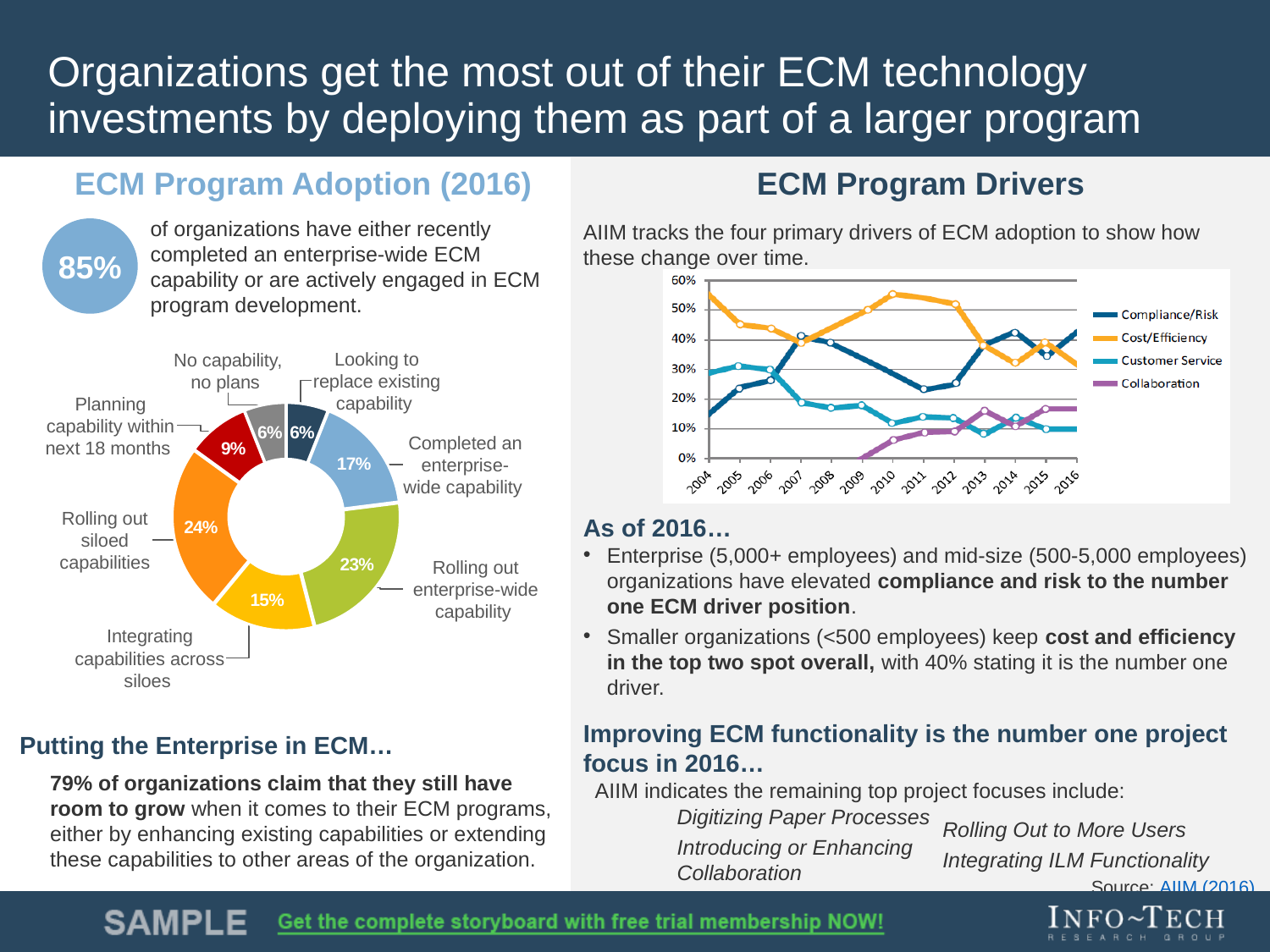
What kind of chart is the ECM Program Adoption (2016) chart? Donut (pie) chart On the ECM Program Adoption (2016) chart, what is the difference between 'Rolling out enterprise-wide capability' and 'Planning capability within next 18 months'? 14% On the ECM Program Adoption (2016) chart, what share is labelled 'Completed an enterprise-wide capability'? 17% On the ECM Program Drivers chart, is the value for Cost/Efficiency in 2004 greater or less than 50%? greater On the ECM Program Adoption (2016) chart, what percentage of organizations are rolling out siloed capabilities? 24% On the ECM Program Adoption (2016) chart, what percentage is shown for 'Integrating capabilities across siloes'? 15% On the ECM Program Drivers chart, is the value for Compliance/Risk in 2004 greater or less than 20%? less On the ECM Program Drivers chart, which is larger in 2004: Cost/Efficiency or Compliance/Risk? Cost/Efficiency On the ECM Program Drivers chart, does the Collaboration series rise or fall from 2009 to 2016? rise On the ECM Program Adoption (2016) chart, how many categories are shown? 7 On the ECM Program Drivers chart, how many series does the legend list? 4 On the ECM Program Adoption (2016) chart, which category has the largest share? Rolling out siloed capabilities